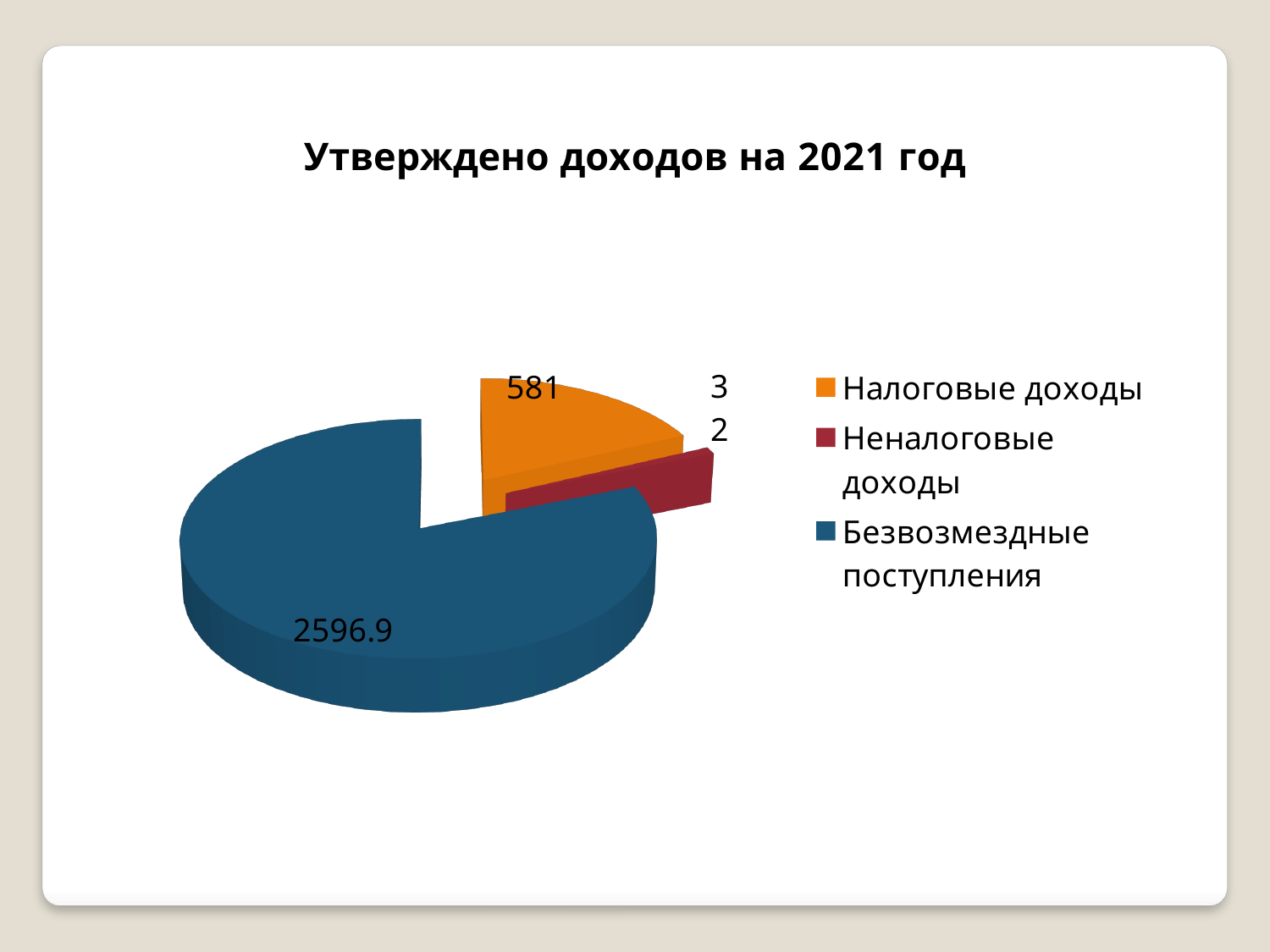
How many entries does the legend list? 3 What is the title of the chart? Утверждено доходов на 2021 год What is the value for Налоговые доходы? 581 Which is larger, Налоговые доходы or Безвозмездные поступления? Безвозмездные поступления What is the value for Безвозмездные поступления? 2596.9 Which category has the largest slice? Безвозмездные поступления What colour is the slice for Безвозмездные поступления? Blue Which is larger, Налоговые доходы or Неналоговые доходы? Налоговые доходы Which category has the smallest slice? Неналоговые доходы What is the difference between Безвозмездные поступления and Налоговые доходы? 2015.9 How many slices does the pie chart have? 3 What kind of chart is shown on the slide? Pie chart